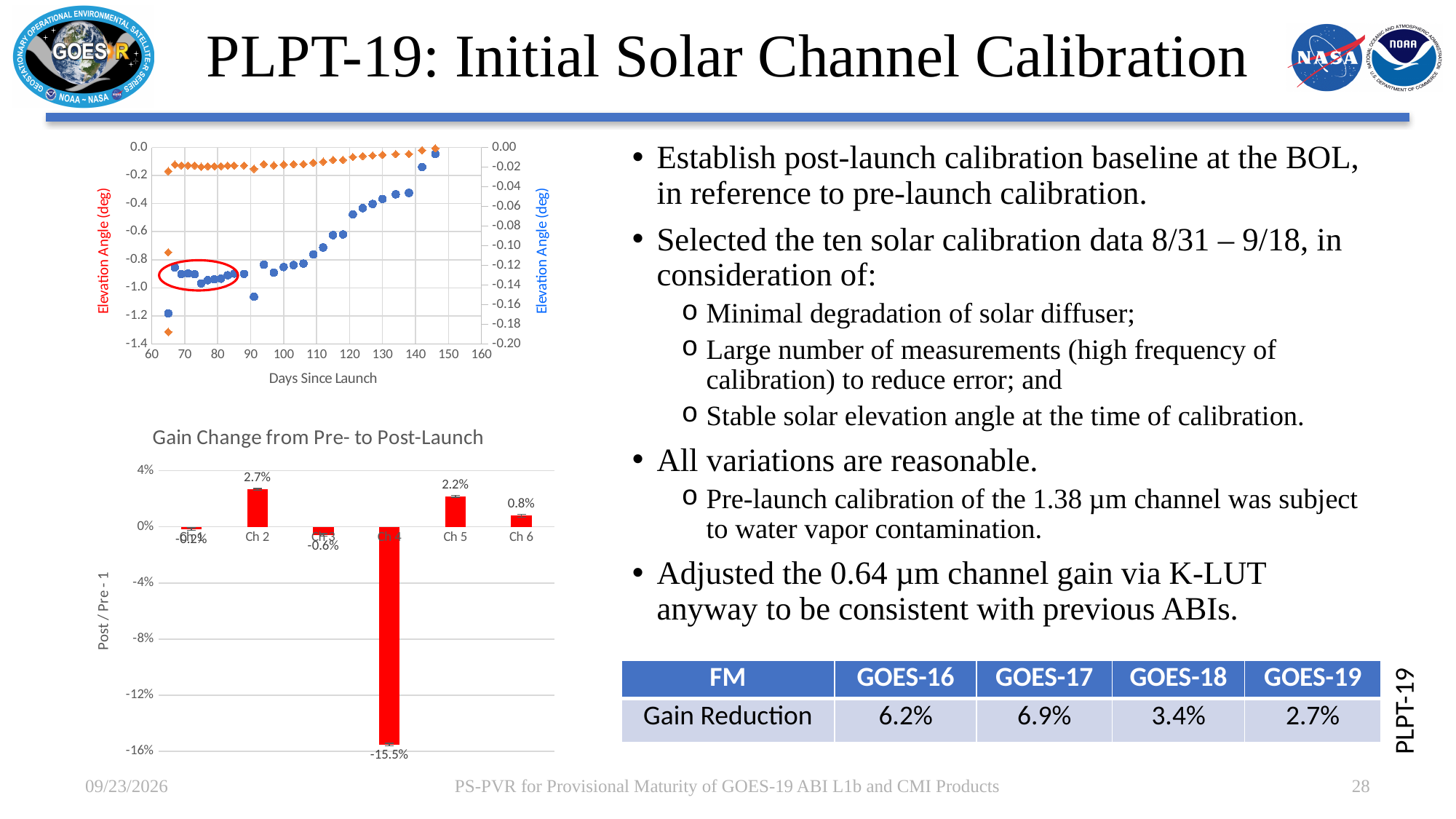
In the 'Gain Change from Pre- to Post-Launch' chart, what is the value for Ch 6? 0.8% In the 'Gain Change from Pre- to Post-Launch' chart, what is the difference between the values for Ch 2 and Ch 5? 0.5% In the 'Gain Change from Pre- to Post-Launch' chart, what is the value for Ch 2? 2.7% In the 'Gain Change from Pre- to Post-Launch' chart, what is the value for Ch 4? -15.5% How many channels are shown in the 'Gain Change from Pre- to Post-Launch' chart? 6 In the 'Gain Change from Pre- to Post-Launch' chart, what is the value for Ch 3? -0.6% In the 'Gain Change from Pre- to Post-Launch' chart, which is larger, the value for Ch 5 or the value for Ch 6? Ch 5 In the top-left chart, do the blue points generally rise or fall as Days Since Launch increases from 90 to 140? Rise What is the x-axis label of the top-left chart on the slide? Days Since Launch In the 'Gain Change from Pre- to Post-Launch' chart, which channel has the highest gain change? Ch 2 What kind of chart is the 'Gain Change from Pre- to Post-Launch' chart? Bar chart In the 'Gain Change from Pre- to Post-Launch' chart, which channel has the lowest gain change? Ch 4